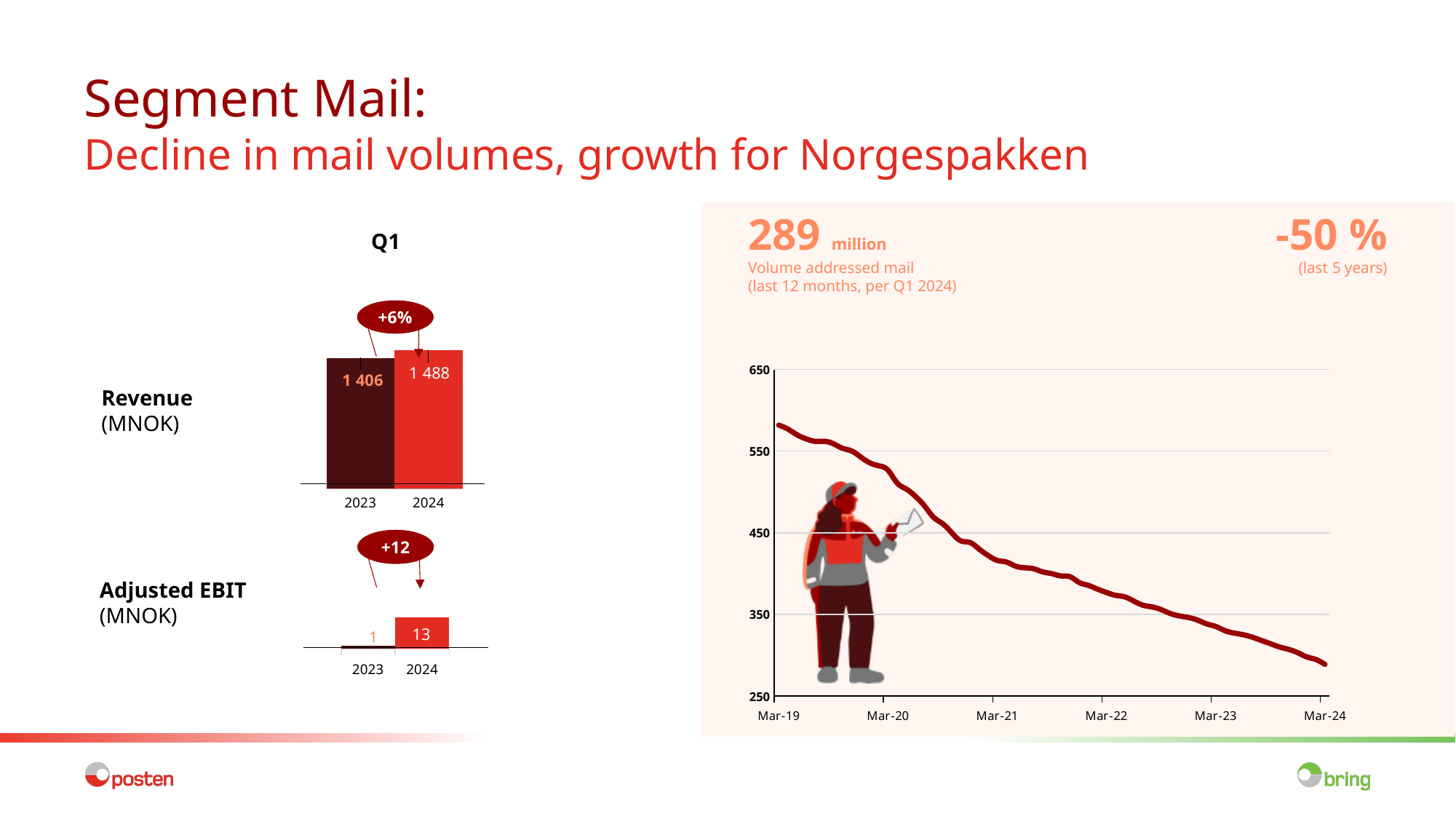
In the line chart on the right, is the value at Mar-24 greater or less than 350? less In the Adjusted EBIT (MNOK) bar chart, what is the value for 2023? 1 In the line chart on the right, do the values rise or fall from Mar-19 to Mar-24? fall In the Revenue (MNOK) bar chart, what is the difference between the 2024 and 2023 values? 82 In the Adjusted EBIT (MNOK) bar chart, which year has the higher value? 2024 In the line chart on the right, is the value at Mar-19 greater or less than 550? greater In the Revenue (MNOK) bar chart, what is the value for 2024? 1 488 In the Revenue (MNOK) bar chart, what percentage change is shown between 2023 and 2024? +6% In the Adjusted EBIT (MNOK) bar chart, what is the value for 2024? 13 What kind of chart is the Revenue (MNOK) chart? bar chart In the Revenue (MNOK) bar chart, what is the value for 2023? 1 406 What kind of chart is the volume addressed mail chart on the right? line chart